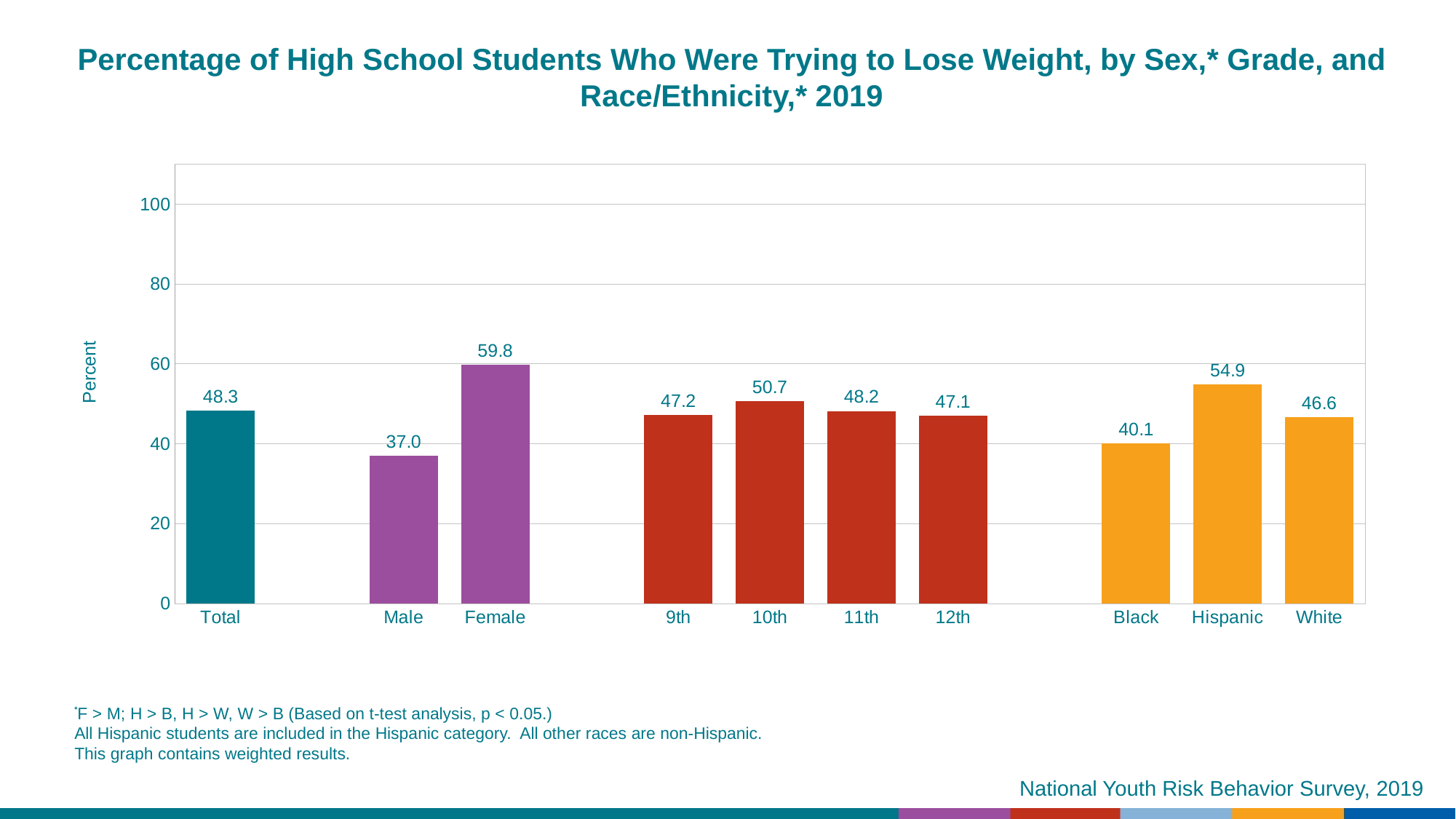
What is the value for 10th grade? 50.7 What is the value for Female? 59.8 Which category has the lowest value? Male What is the value for Male? 37.0 What is the difference between the Hispanic and Black values? 14.8 What kind of chart is this? bar chart How many bars are shown in the chart? 10 What is the difference between the Female and Male values? 22.8 What is the value for Hispanic? 54.9 Is the value for Black greater or less than 60? less Which is larger, the value for 10th grade or the value for 12th grade? 10th Which category has the highest value? Female